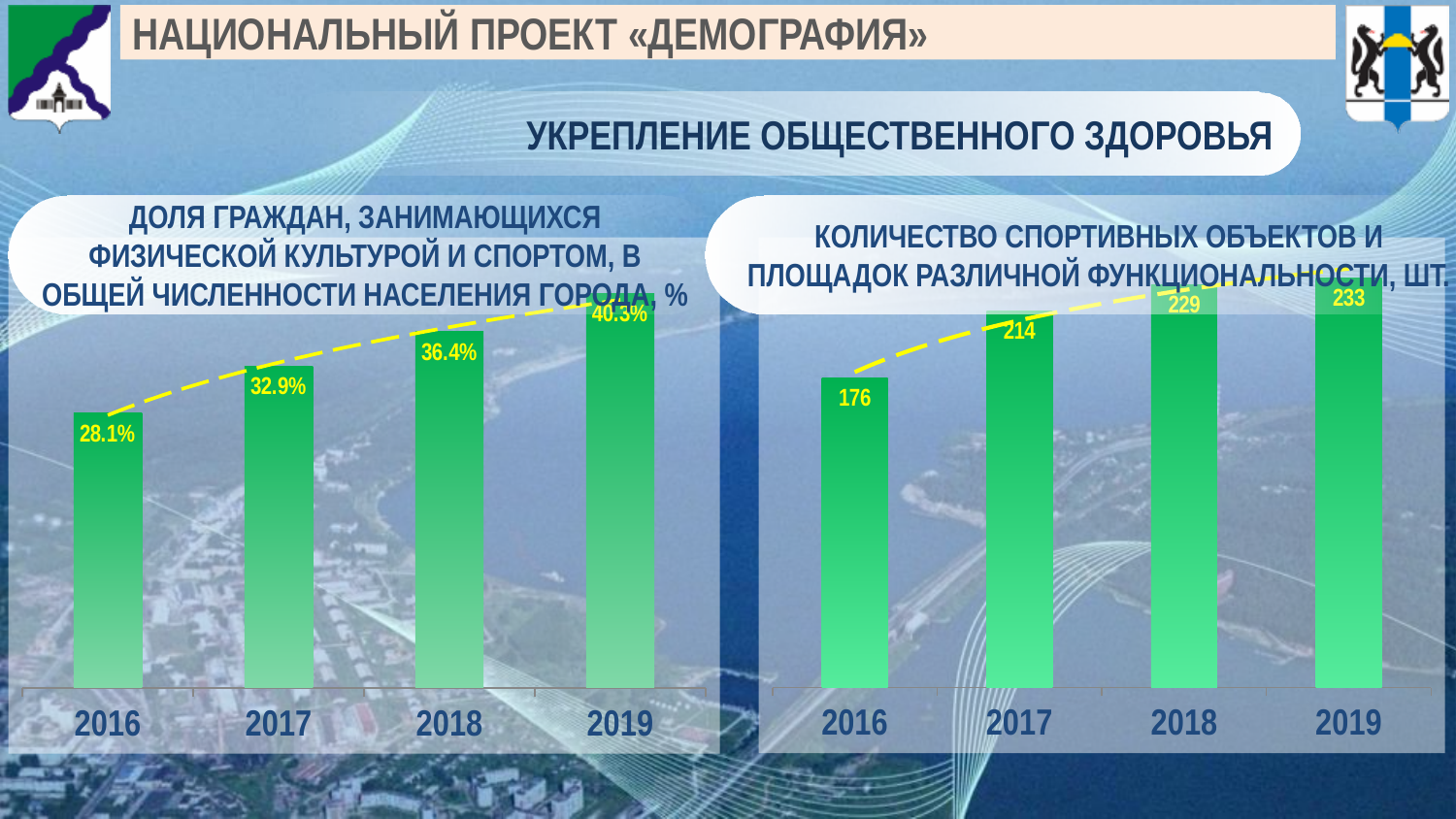
In the right chart (number of sports facilities), which year has the lowest value? 2016 What type of chart is the left chart? bar chart In the left chart (share of citizens engaged in physical culture and sport), which year has the highest value? 2019 Do the values in the right chart (number of sports facilities) rise or fall from 2016 to 2019? rise In the right chart (number of sports facilities), which is larger, the value for 2017 or the value for 2018? 2018 How many years are shown on the x axis of the left chart? 4 In the left chart (share of citizens engaged in physical culture and sport), what is the value for 2019? 40.3% In the right chart (number of sports facilities), what is the value for 2017? 214 In the left chart (share of citizens engaged in physical culture and sport), what is the value for 2016? 28.1% In the right chart (number of sports facilities), what is the value for 2018? 229 In the right chart (number of sports facilities), what is the difference between the 2019 and 2016 values? 57 In the left chart (share of citizens engaged in physical culture and sport), what is the difference between the 2018 and 2017 values? 3.5%